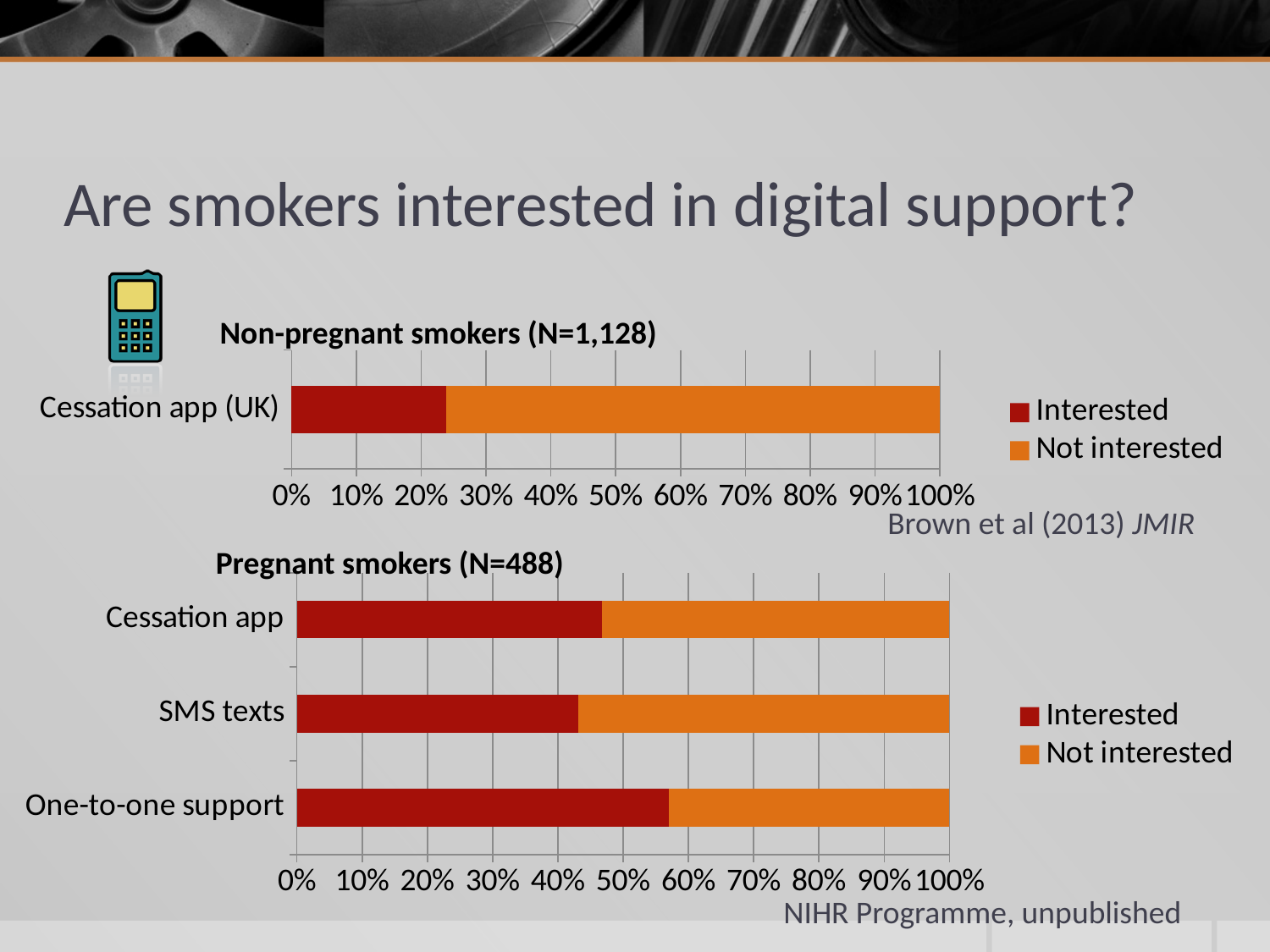
In the 'Non-pregnant smokers (N=1,128)' chart, is the Interested share for Cessation app (UK) greater or less than 30%? less What are the two legend entries in the 'Non-pregnant smokers (N=1,128)' chart? Interested, Not interested How many categories are shown in the 'Non-pregnant smokers (N=1,128)' chart? 1 What colour represents 'Not interested' in the 'Pregnant smokers (N=488)' chart? Orange In the 'Pregnant smokers (N=488)' chart, which category has the highest Interested share? One-to-one support How many series does the legend of the 'Pregnant smokers (N=488)' chart list? 2 What kind of chart is the 'Non-pregnant smokers (N=1,128)' chart? Stacked bar chart In the 'Pregnant smokers (N=488)' chart, is the Interested share for SMS texts greater or less than 50%? less How many categories are shown in the 'Pregnant smokers (N=488)' chart? 3 In the 'Pregnant smokers (N=488)' chart, is the Interested share for One-to-one support greater or less than 50%? greater In the 'Pregnant smokers (N=488)' chart, which has a larger Interested share: SMS texts or One-to-one support? One-to-one support